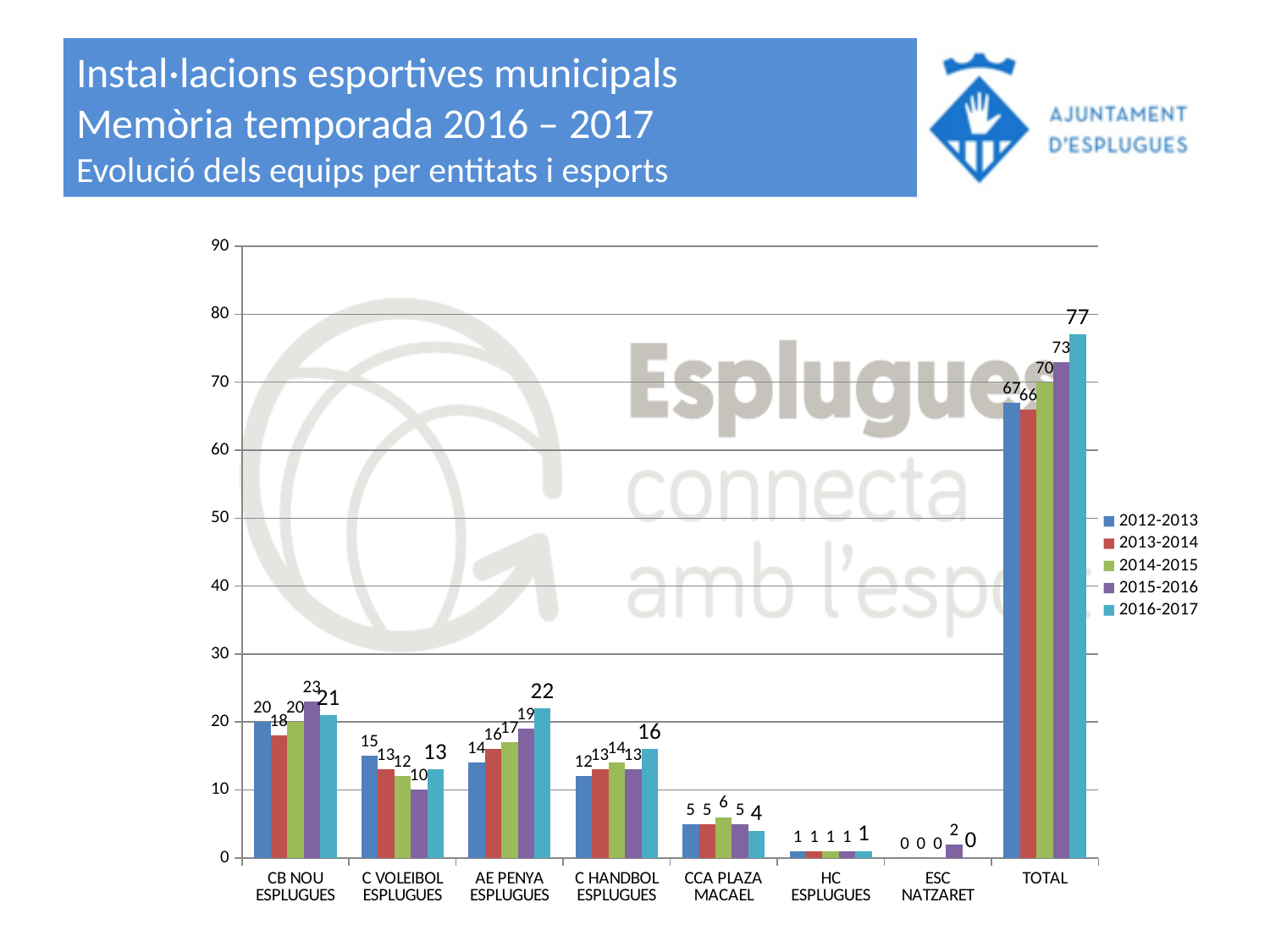
Which is larger for 2016-2017: CB NOU ESPLUGUES or AE PENYA ESPLUGUES? AE PENYA ESPLUGUES What is the difference between the TOTAL values for 2016-2017 and 2012-2013? 10 Which season has the lowest TOTAL value? 2013-2014 What is the value for AE PENYA ESPLUGUES in the 2016-2017 series? 22 Which season has the highest TOTAL value? 2016-2017 Do the values for AE PENYA ESPLUGUES rise or fall from 2012-2013 to 2016-2017? Rise What is the value for C VOLEIBOL ESPLUGUES in 2015-2016? 10 What is the TOTAL value for the 2012-2013 series? 67 How many series does the legend list? 5 How many categories are shown on the x axis? 8 What is the value for ESC NATZARET in 2015-2016? 2 What kind of chart is shown on the slide? Bar chart